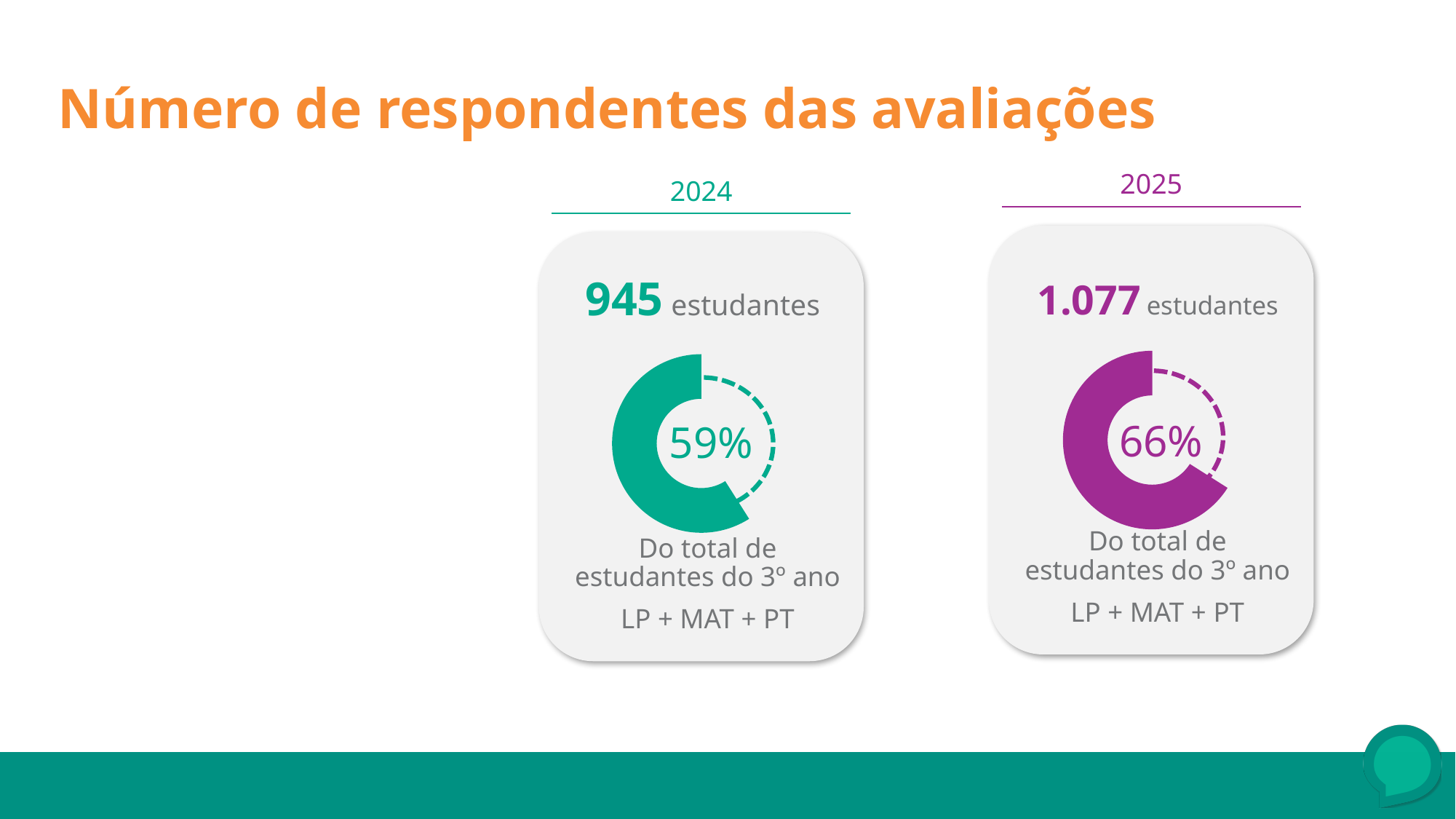
What kind of chart is used in the 2024 and 2025 panels? Donut chart In the 2024 chart, how many students responded? 945 estudantes How many charts are shown on the slide? 2 In the 2025 chart, how many students responded? 1.077 estudantes In the 2024 chart, what percentage of the total 3rd-year students is shown? 59% What is the difference in percentage points between the 2025 chart (66%) and the 2024 chart (59%)? 7 percentage points In the 2025 chart, what percentage of the total 3rd-year students is shown? 66% Which year's chart shows the higher percentage of respondents, 2024 or 2025? 2025 Which year's chart shows the lower number of student respondents? 2024 How many more students responded in 2025 (1.077) than in 2024 (945)? 132 Does the percentage of respondents rise or fall from 2024 to 2025? Rise What colour is the 2025 donut chart? Purple